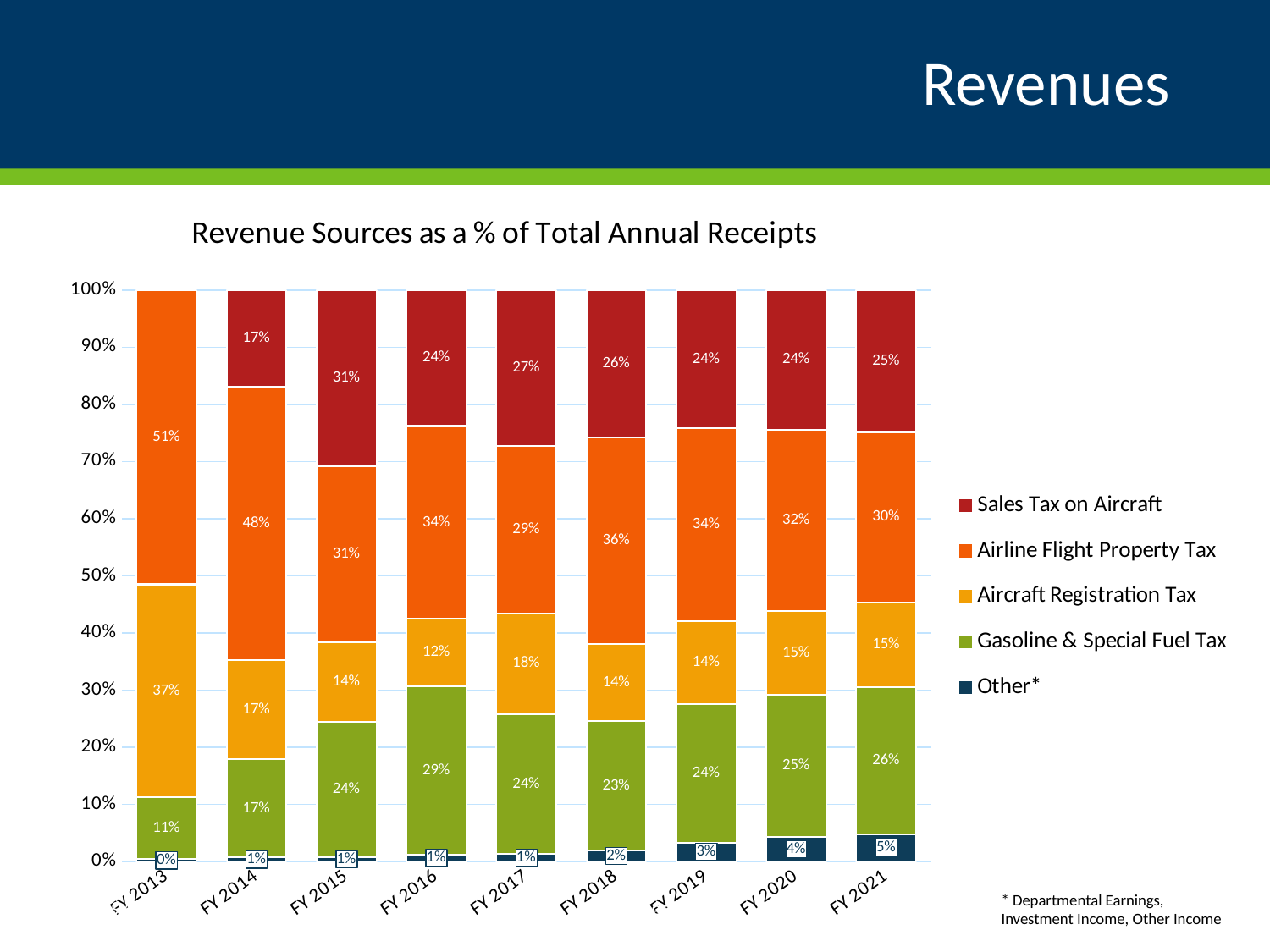
What is the value for Sales Tax on Aircraft in FY 2015? 31% What is the value for Gasoline & Special Fuel Tax in FY 2016? 29% In which fiscal year is the Airline Flight Property Tax share the highest? FY 2013 Which is larger in FY 2018: Airline Flight Property Tax or Sales Tax on Aircraft? Airline Flight Property Tax What kind of chart is shown on the slide? Stacked bar chart In which fiscal year is the Other* share the highest? FY 2021 What is the difference between the Airline Flight Property Tax share in FY 2014 and in FY 2021? 18% What is the value for Airline Flight Property Tax in FY 2013? 51% How many series does the legend list? 5 In which fiscal year is the Gasoline & Special Fuel Tax share the lowest? FY 2013 What is the value for Aircraft Registration Tax in FY 2017? 18% How many fiscal years are shown on the x axis? 9